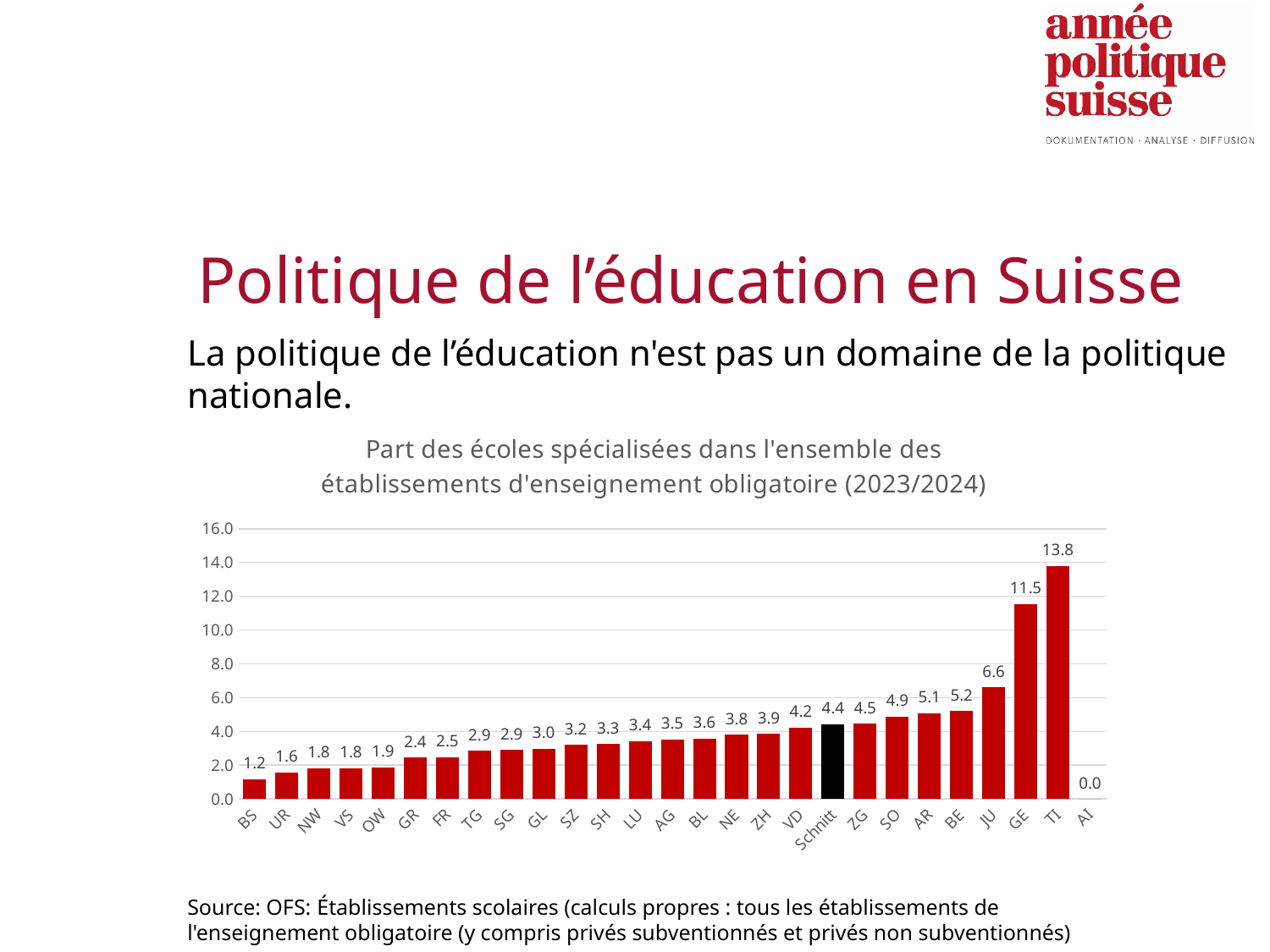
Which is larger, the value for ZH or the value for VD? VD Which category has the highest value? TI Is the value for JU greater or less than 6.0? greater Which bar is coloured black instead of red? Schnitt What kind of chart is shown on the slide? Bar chart What is the difference between the values for TI and GE? 2.3 How many bars are shown in the chart? 27 Which category has the lowest value? AI What is the difference between the values for JU and BE? 1.4 What is the value for TI? 13.8 What is the value for the bar labelled Schnitt? 4.4 What is the value for GE? 11.5